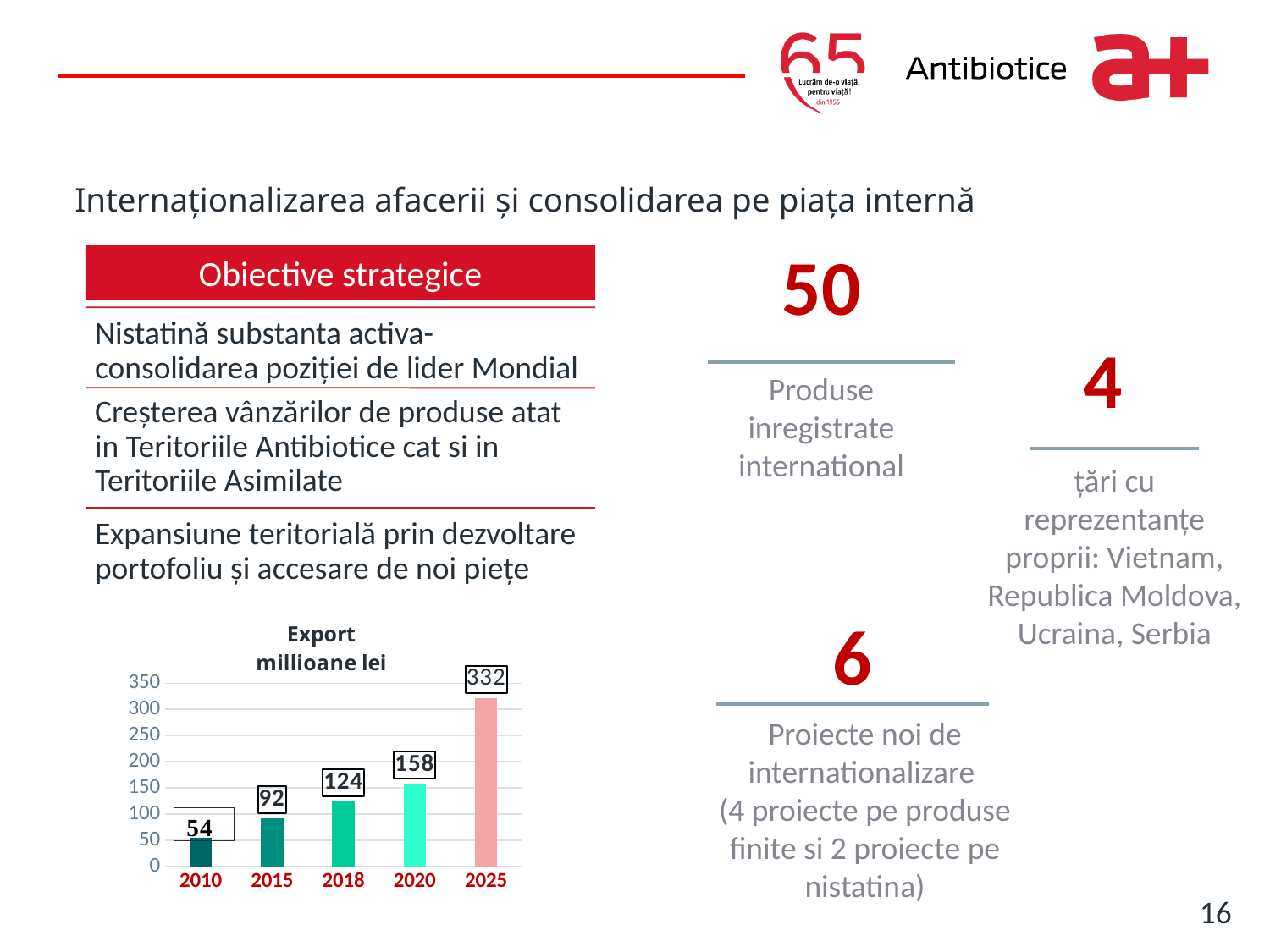
Do the export values rise or fall from 2010 to 2025? rise What is the title of the chart? Export millioane lei What is the export value shown for 2018? 124 What is the difference between the export values for 2025 and 2020? 174 Which is larger, the export value for 2018 or for 2020? 2020 What is the difference between the export values for 2015 and 2010? 38 What is the export value shown for 2025? 332 Which year has the highest export value? 2025 Which year has the lowest export value? 2010 What is the export value shown for 2010? 54 How many years are shown on the export chart? 5 What kind of chart is the export chart? bar chart